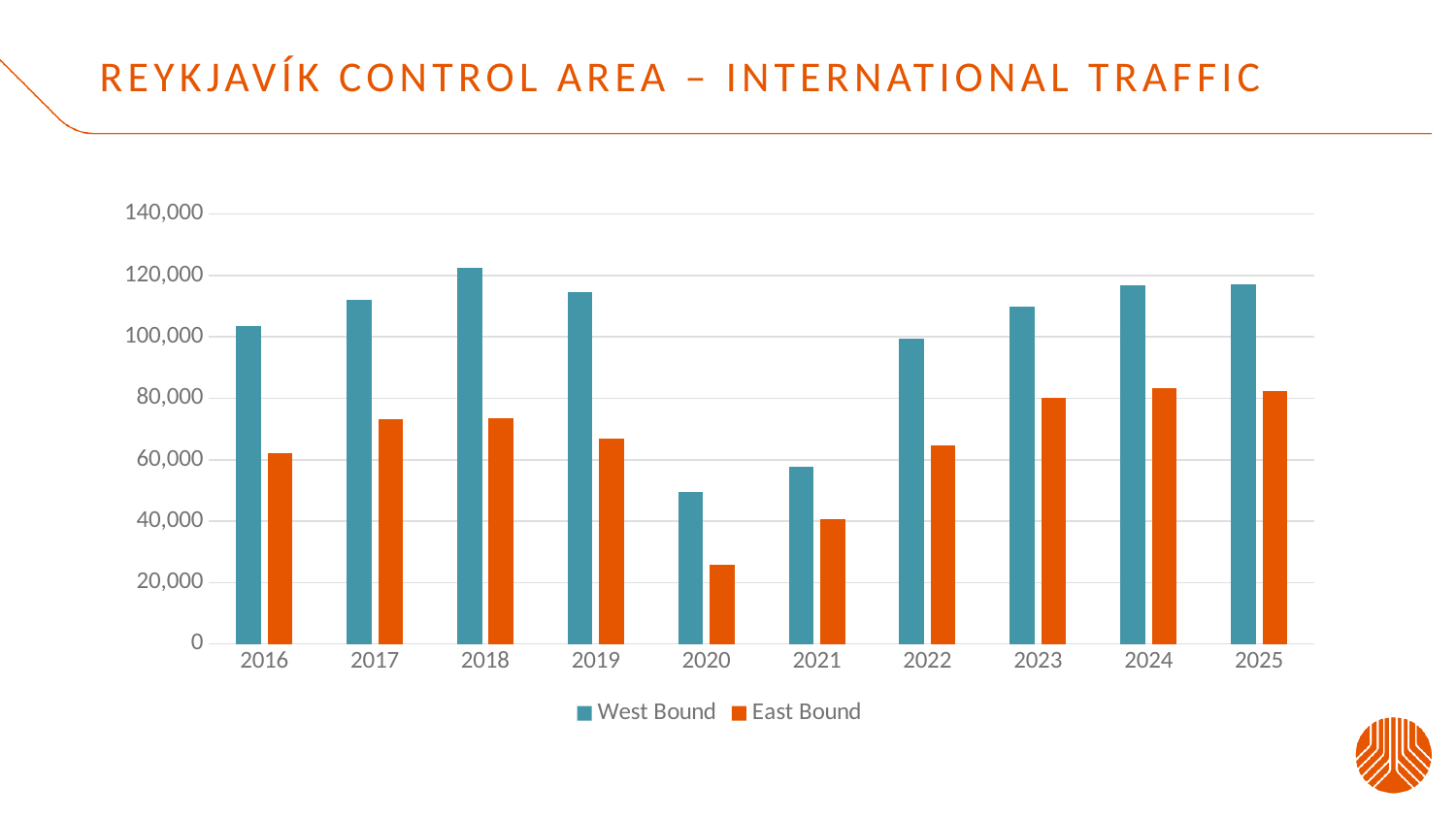
Is the East Bound value for 2020 greater or less than 40,000? less Do the West Bound values rise or fall from 2019 to 2020? fall Which year has the highest West Bound value? 2018 How many years are shown on the x axis? 10 How many series does the legend list? 2 Which year has the lowest West Bound value? 2020 Is the West Bound value for 2020 greater or less than 60,000? less What kind of chart is shown on the slide? Bar chart Is the East Bound value for 2023 greater or less than 60,000? greater Which is larger, the West Bound value for 2018 or for 2019? 2018 Which year has the lowest East Bound value? 2020